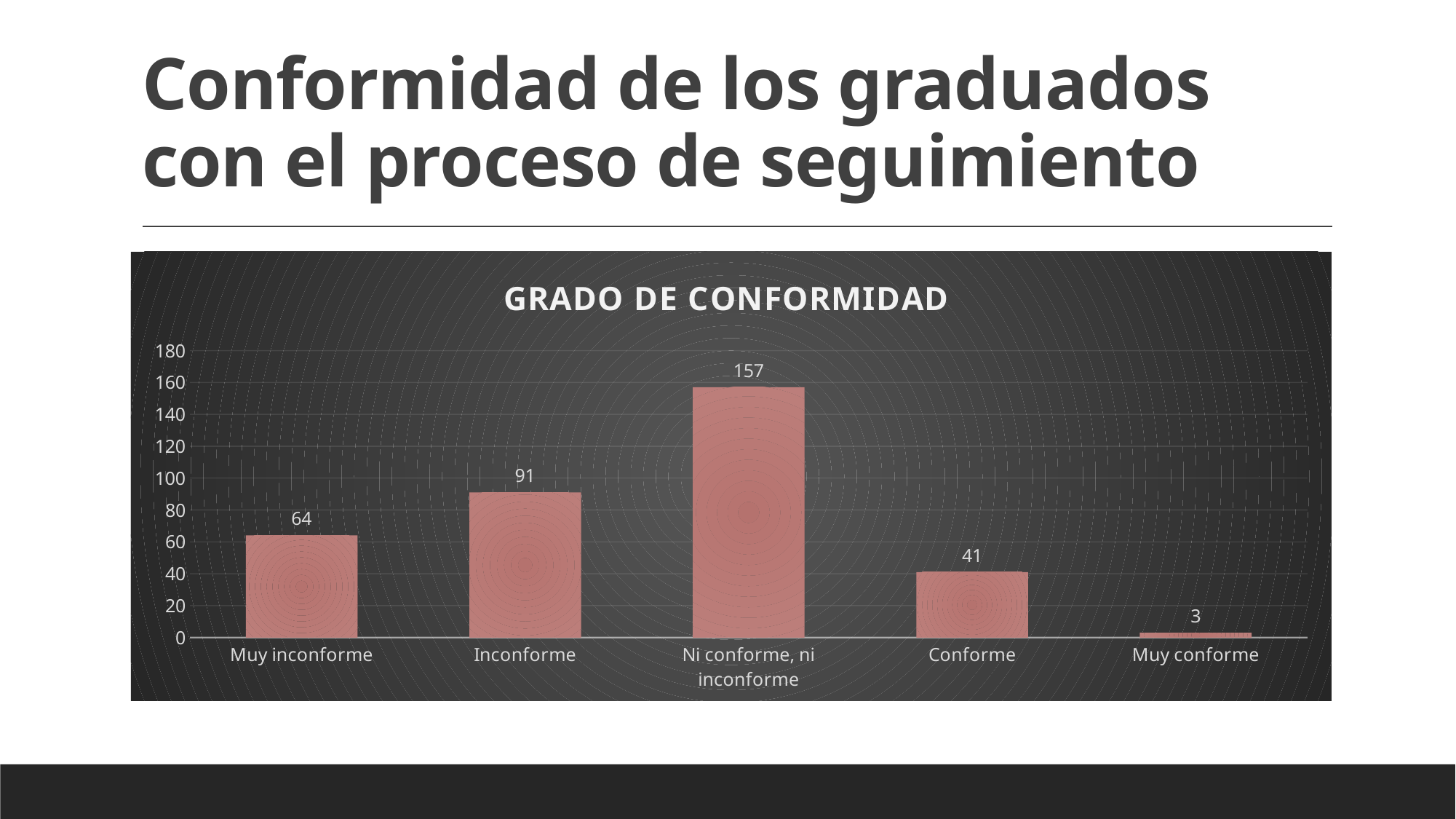
What is the value for Muy conforme? 3 What is the value for Ni conforme, ni inconforme? 157 What is the value for Conforme? 41 Which is larger, the value for Conforme or the value for Muy inconforme? Muy inconforme Which category has the lowest value? Muy conforme What is the title of the chart? GRADO DE CONFORMIDAD Which category has the highest value? Ni conforme, ni inconforme What is the difference between the values for Inconforme and Muy inconforme? 27 How many categories are shown on the x axis? 5 What is the value for Inconforme? 91 What is the value for Muy inconforme? 64 What kind of chart is shown on the slide? Bar chart